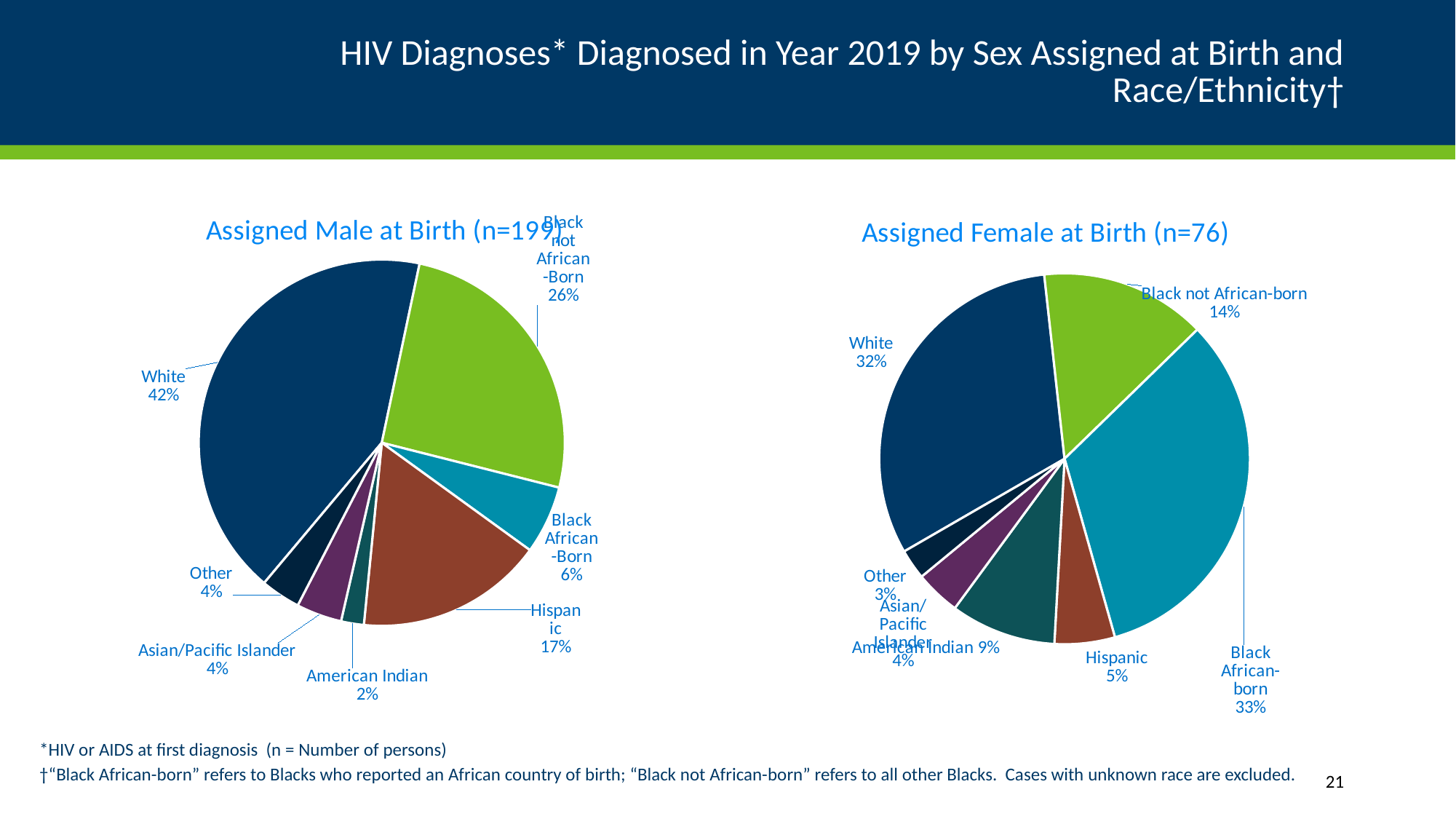
In the Assigned Female at Birth chart, what share of diagnoses is Black African-born? 33% In the Assigned Male at Birth chart, which race/ethnicity has the smallest share? American Indian In the Assigned Male at Birth chart, what is the difference in percentage points between the White share and the Black not African-Born share? 16 In the Assigned Male at Birth chart, which race/ethnicity has the largest share? White What is the n value shown in the title of the Assigned Female at Birth chart? 76 In the Assigned Female at Birth chart, which race/ethnicity has the smallest share? Other In the Assigned Female at Birth chart, what share of diagnoses is American Indian? 9% In the Assigned Male at Birth chart, what share of diagnoses is Hispanic? 17% What type of chart is used on this slide? Pie chart In the Assigned Male at Birth chart, what share of diagnoses is White? 42% How many race/ethnicity slices does the Assigned Female at Birth pie chart have? 7 In the Assigned Female at Birth chart, which is larger: the Black not African-born share or the Hispanic share? Black not African-born